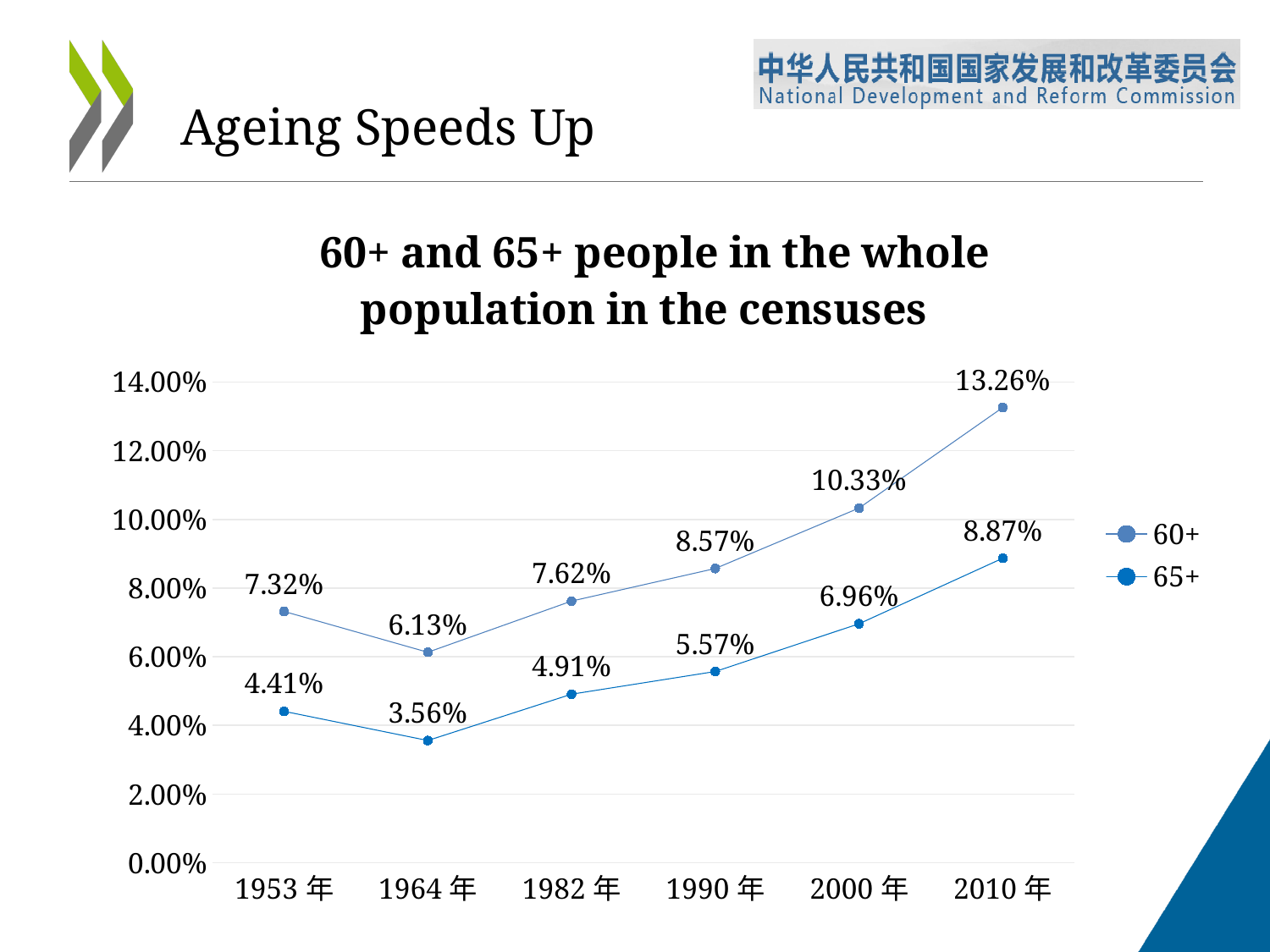
Is the 60+ value in 2000 年 greater or less than 10.00%? greater What is the value for the 60+ series in 2010 年? 13.26% In which census year is the 60+ series lowest? 1964 年 What is the value for the 60+ series in 1953 年? 7.32% In which census year is the 65+ series highest? 2010 年 Which is larger: the 60+ value in 1990 年 or the 60+ value in 1982 年? 1990 年 What is the difference between the 60+ and 65+ values in 2000 年? 3.37% What kind of chart is shown on the slide? line chart From 1964 年 to 2010 年, does the 65+ series rise or fall? rise What is the value for the 65+ series in 1964 年? 3.56% How many series does the legend list? 2 How many census years are shown on the x axis? 6